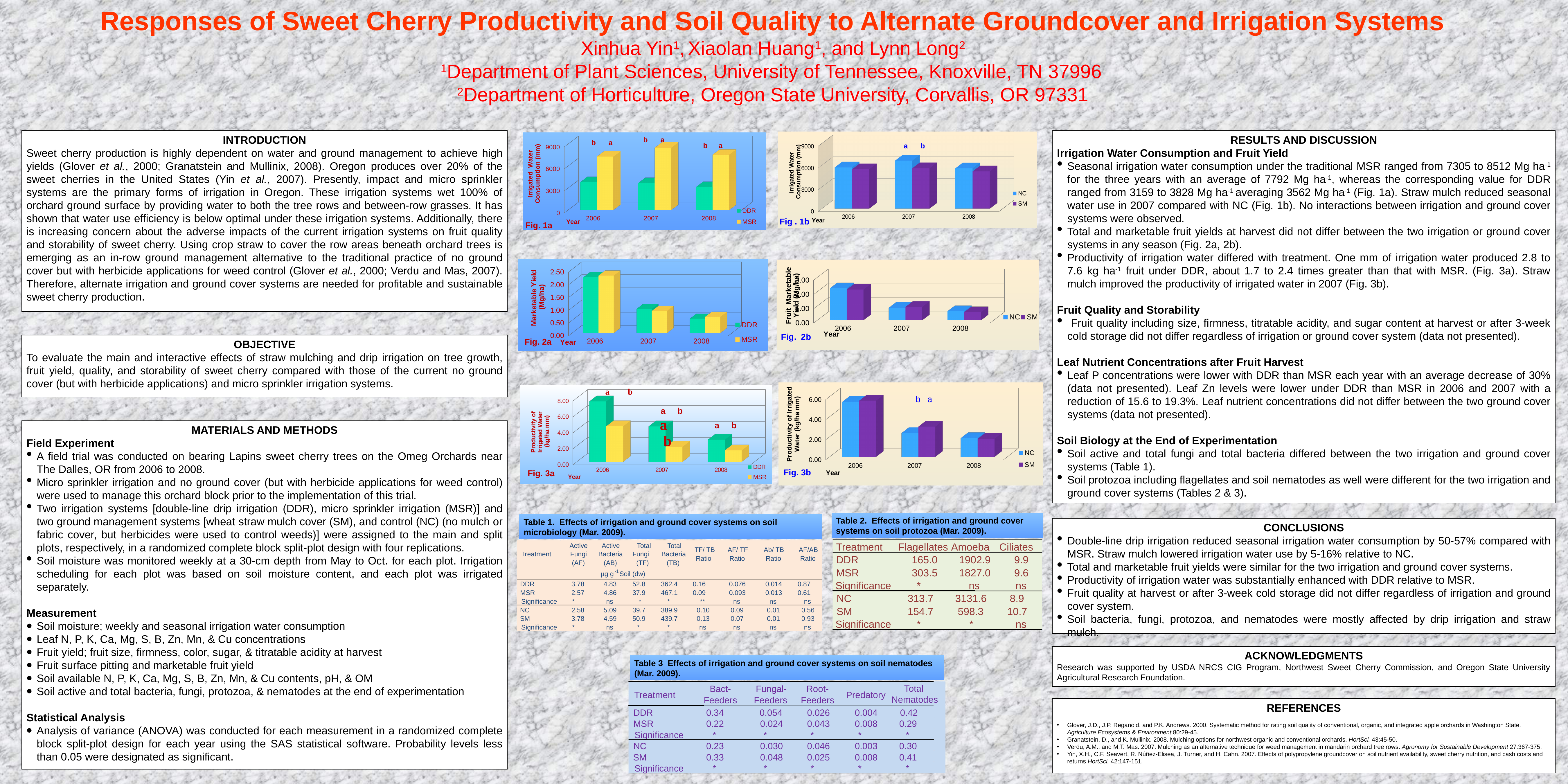
In Fig. 1a, how many years are shown on the x axis? 3 In Fig. 2a, do the marketable yield values rise or fall from 2006 to 2008? fall In Fig. 1a, is the value for DDR in 2006 greater or less than 6000? less In Fig. 1a, how many series does the legend list? 2 In Fig. 3b, what are the two series listed in the legend? NC and SM In Fig. 2a, is the value for DDR in 2006 greater or less than 2.00? greater In Fig. 1a, which bar is the highest? MSR in 2007 What kind of chart is Fig. 1a? bar chart In Fig. 3a, is the value for MSR in 2008 greater or less than 2.00? less In Fig. 3a, which series has the larger value in 2006, DDR or MSR? DDR In Fig. 1b, which series has the larger value in 2007, NC or SM? NC